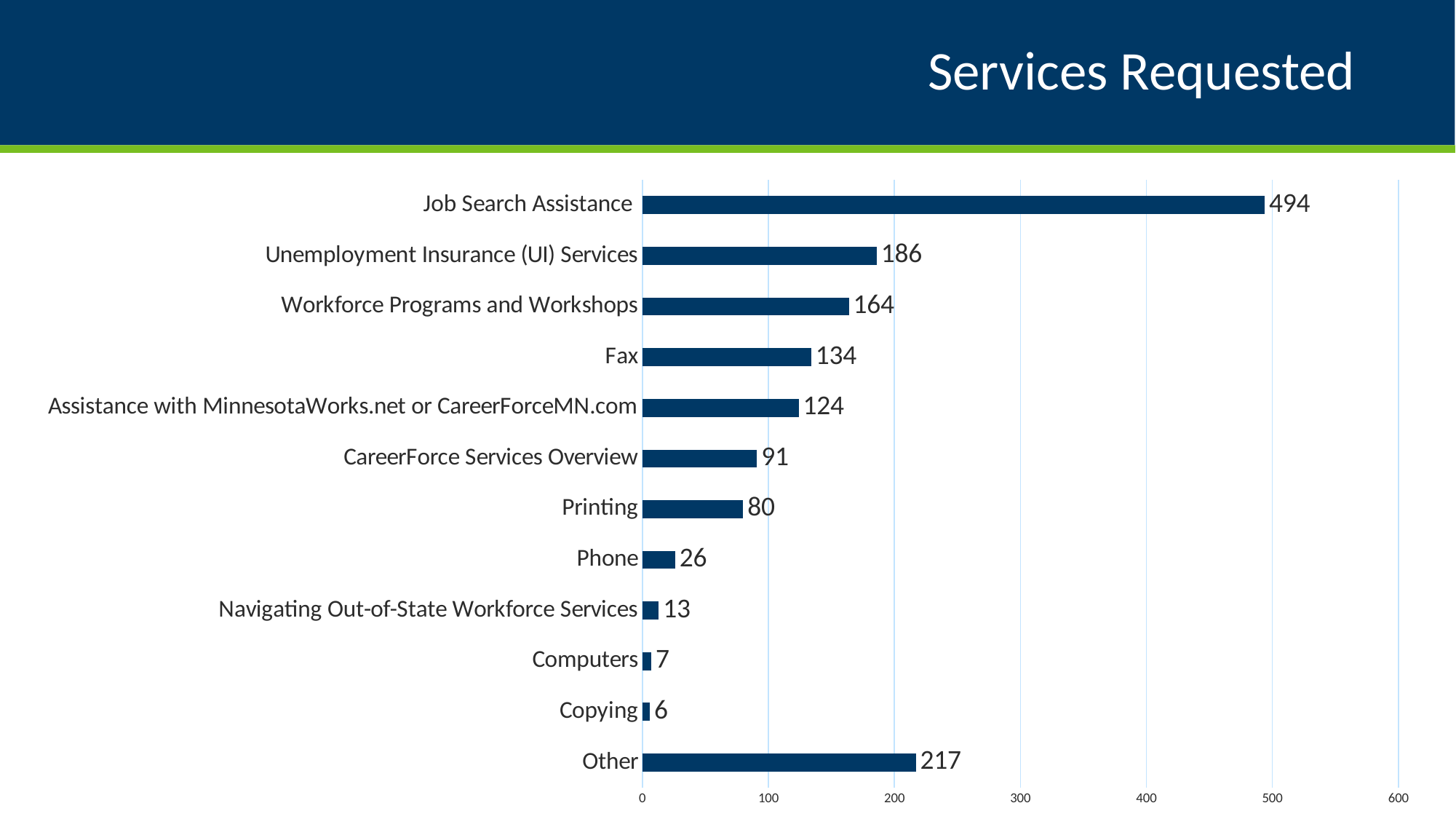
What is the value for Other? 217 How many categories are shown in the chart? 12 What is the title of the slide? Services Requested Which is larger, Printing or CareerForce Services Overview? CareerForce Services Overview Which category has the highest value? Job Search Assistance What is the value for Job Search Assistance? 494 What is the difference between Unemployment Insurance (UI) Services and Workforce Programs and Workshops? 22 Is the value for Assistance with MinnesotaWorks.net or CareerForceMN.com greater or less than 100? greater What is the value for Fax? 134 What kind of chart is shown on the slide? Bar chart What is the value for Navigating Out-of-State Workforce Services? 13 Which category has the lowest value? Copying